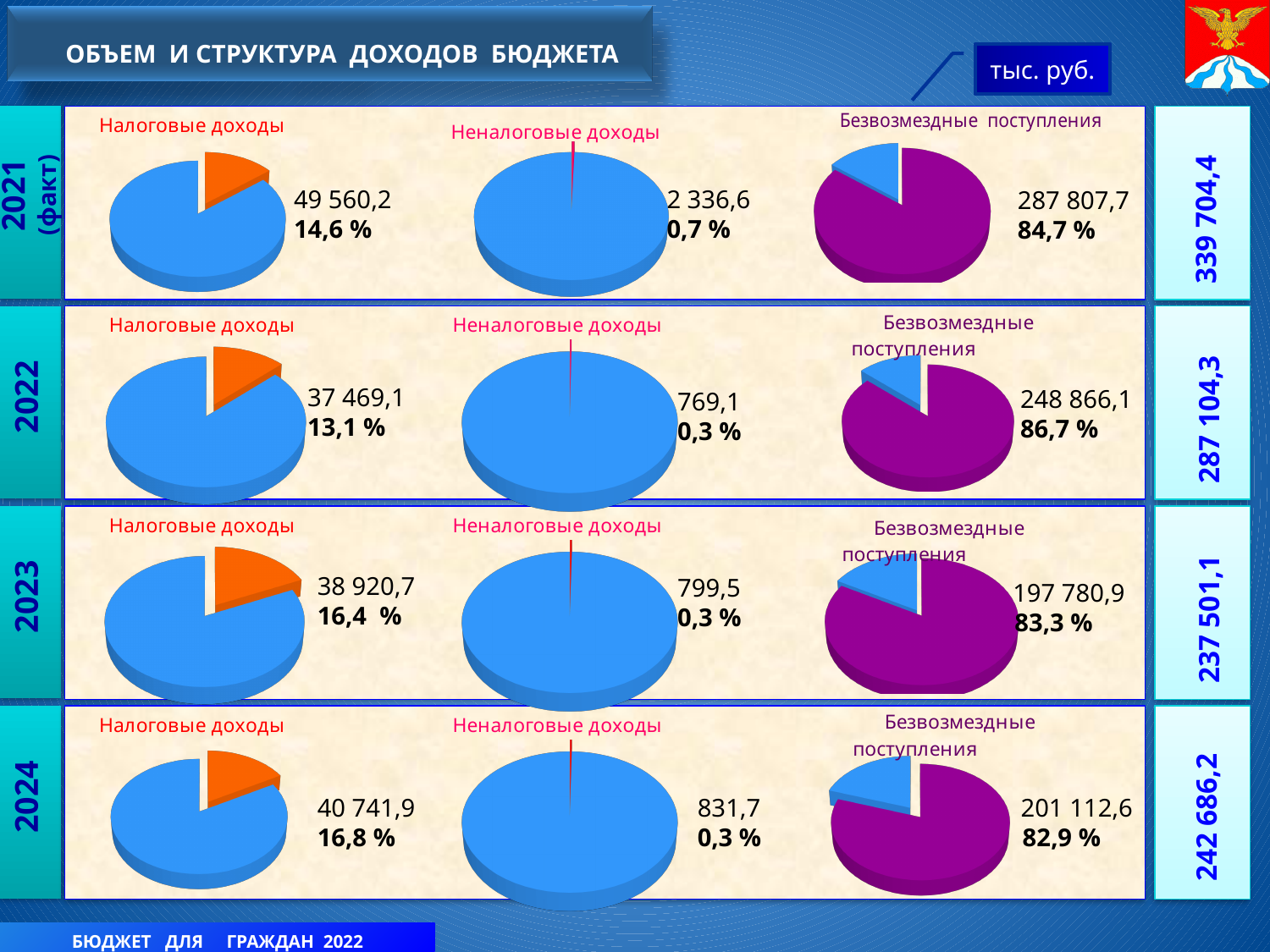
What is the difference between the Налоговые доходы value in the 2024 row and the Налоговые доходы value in the 2023 row? 1 821,2 In the 2021 (факт) row, what value is shown on the Налоговые доходы pie chart? 49 560,2 What kind of chart is used for Безвозмездные поступления in the 2024 row? pie chart Across the four rows, which year shows the highest value on the Безвозмездные поступления pie chart? 2021 (факт) How many pie charts are shown on the slide in total? 12 What unit of measurement is indicated in the top-right box of the slide? тыс. руб. Across the four rows, which year shows the lowest value on the Неналоговые доходы pie chart? 2022 In the 2023 row, what value is shown on the Неналоговые доходы pie chart? 799,5 In the 2022 row, what share of the Безвозмездные поступления pie chart does the highlighted slice represent? 86,7 % In the 2024 row, what percentage is shown on the Налоговые доходы pie chart? 16,8 % What total is shown at the right of the 2022 row? 287 104,3 Which is larger: the Налоговые доходы value in the 2022 row or the Налоговые доходы value in the 2023 row? 2023 (38 920,7)